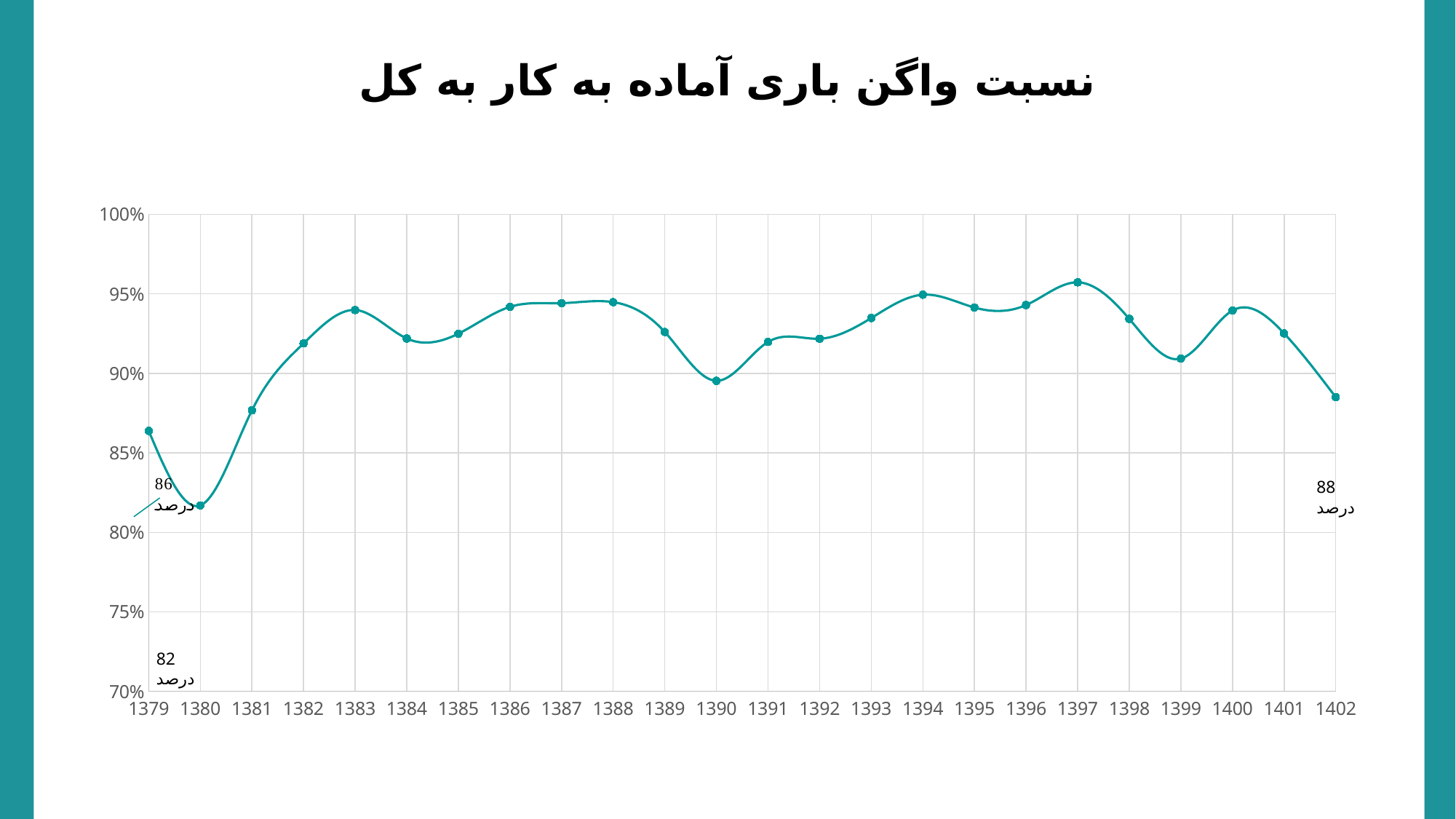
Which year has the highest value on the chart? 1397 Is the value for 1383 greater or less than 90%? greater Which year has the lowest value on the chart? 1380 What is the labelled value for 1379? 86 درصد What is the title of the chart? نسبت واگن باری آماده به کار به کل What kind of chart is shown on the slide? line chart By how many percentage points does the labelled value for 1402 exceed the labelled value for 1380? 6 What is the labelled value for 1380? 82 درصد Do the values rise or fall from 1400 to 1402? fall Which year has the larger value, 1383 or 1384? 1383 What is the labelled value for 1402? 88 درصد How many years (data points) are plotted along the x axis? 24